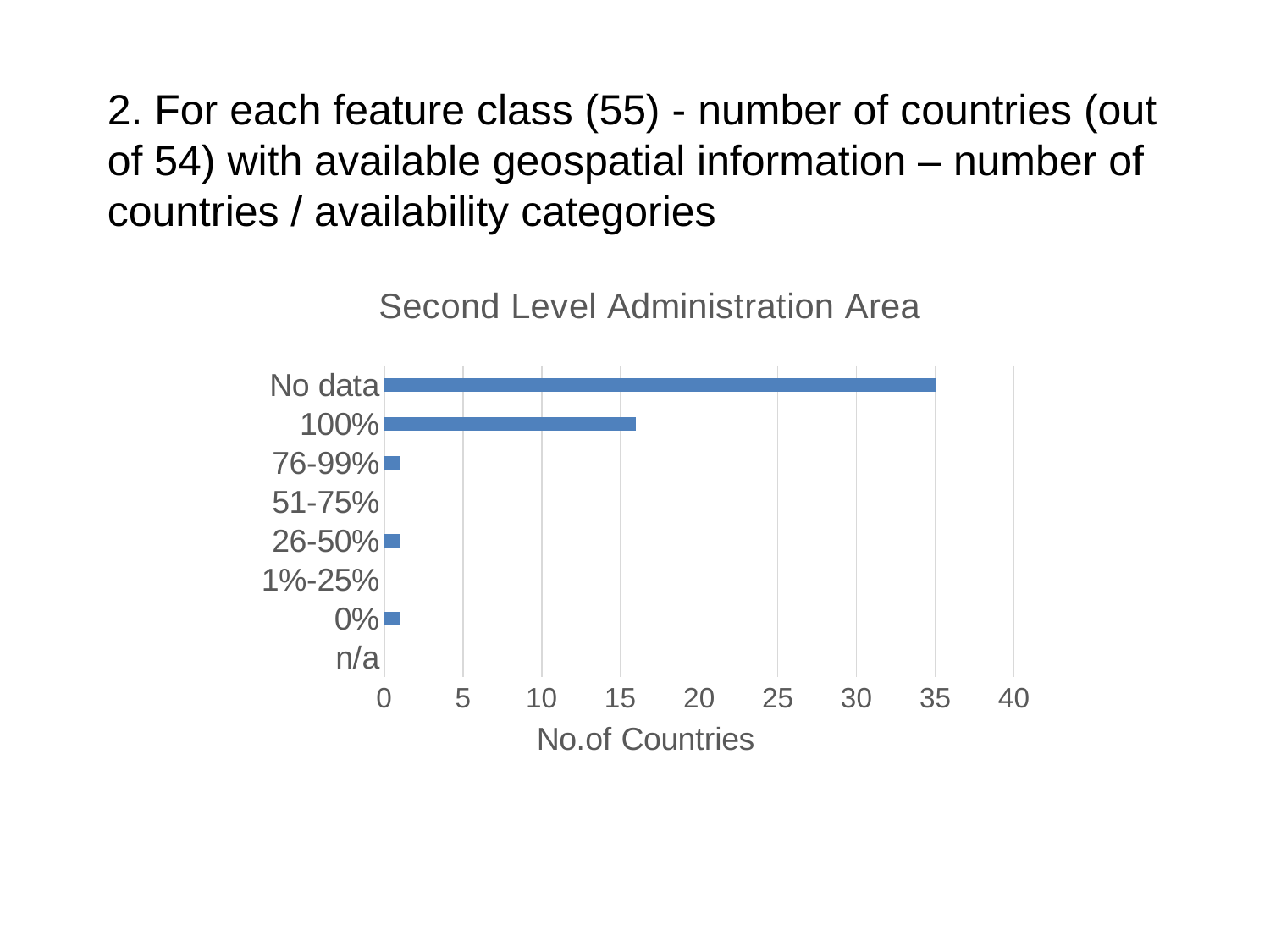
Which category has the highest number of countries? No data What is the title of the chart? Second Level Administration Area Is the value for '100%' greater or less than 20? less What is the label of the horizontal axis? No.of Countries Which has more countries, '100%' or '0%'? 100% Is the value for '100%' greater or less than 15? greater Is the value for '26-50%' greater or less than 5? less How many categories are shown on the vertical axis of the chart? 8 What type of chart is shown on the slide? bar chart Which has more countries, 'No data' or '100%'? No data What is the number of countries for the 'No data' category? 35